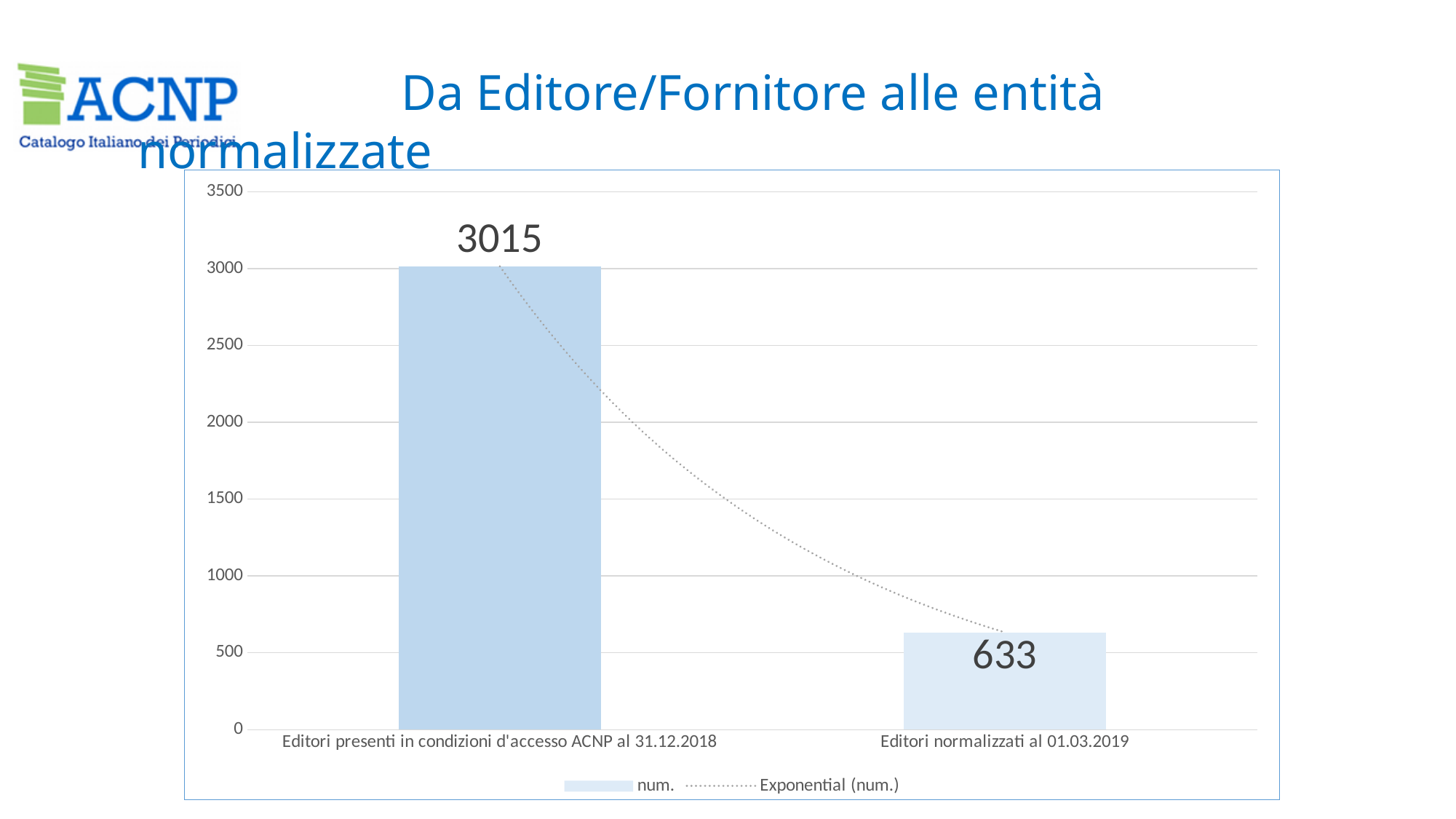
Is the value for 'Editori presenti in condizioni d'accesso ACNP al 31.12.2018' greater or less than 2500? greater What is the value for 'Editori normalizzati al 01.03.2019'? 633 What kind of chart is shown on the slide? bar chart Which category has the highest value? Editori presenti in condizioni d'accesso ACNP al 31.12.2018 Which category has the lowest value? Editori normalizzati al 01.03.2019 Is the value for 'Editori normalizzati al 01.03.2019' greater or less than 1000? less Which is larger: the value for 'Editori presenti in condizioni d'accesso ACNP al 31.12.2018' or the value for 'Editori normalizzati al 01.03.2019'? Editori presenti in condizioni d'accesso ACNP al 31.12.2018 How many entries does the legend list? 2 What is the name of the trendline entry in the legend? Exponential (num.) What is the value for 'Editori presenti in condizioni d'accesso ACNP al 31.12.2018'? 3015 How many categories are shown on the x axis? 2 What is the difference between the value for 'Editori presenti in condizioni d'accesso ACNP al 31.12.2018' and the value for 'Editori normalizzati al 01.03.2019'? 2382